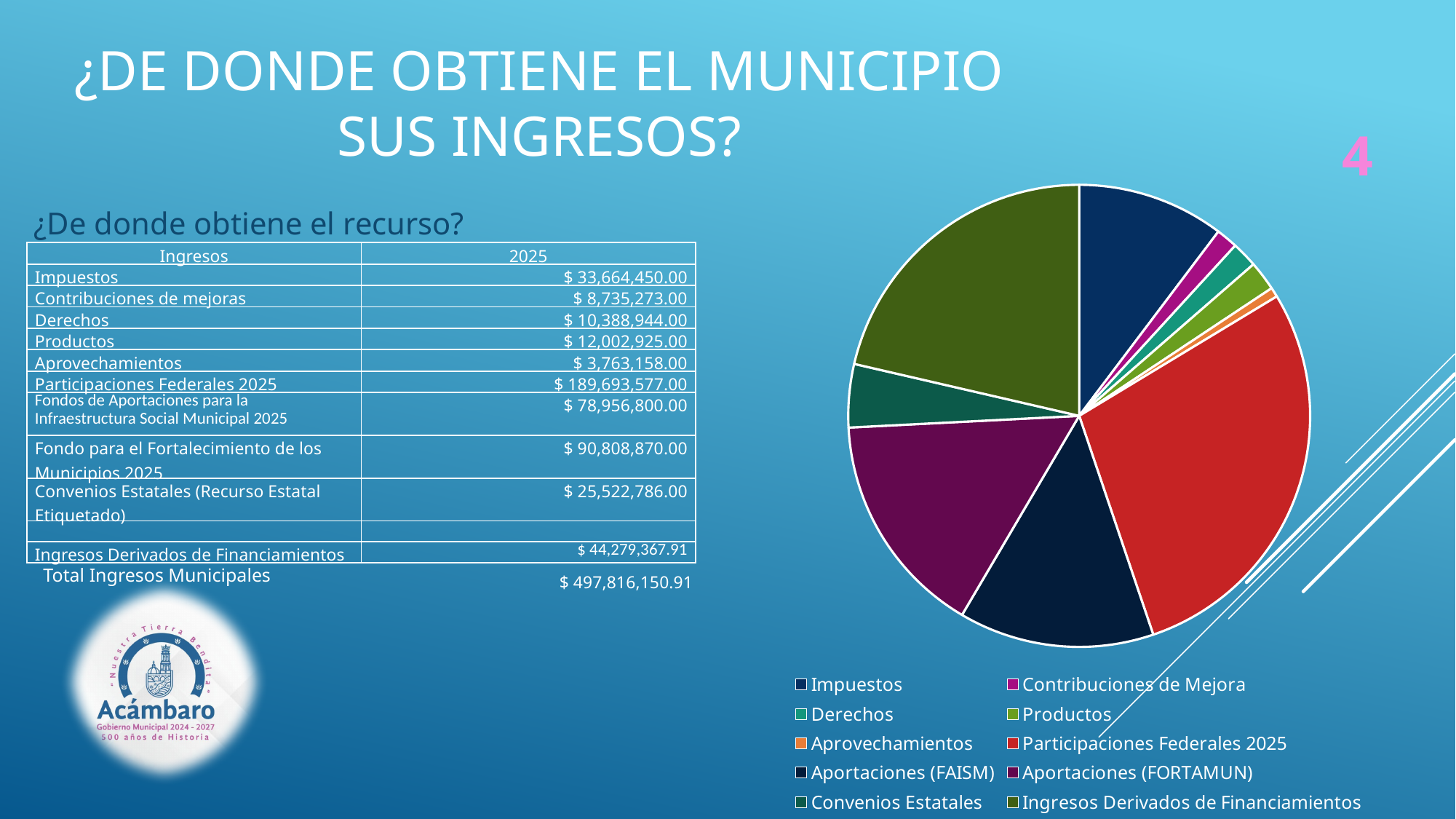
How many entries does the pie chart's legend list? 10 What is the 2025 value for Aprovechamientos? $ 3,763,158.00 What is the 2025 value for Participaciones Federales 2025? $ 189,693,577.00 What kind of chart is shown on the slide? pie chart What is the Total Ingresos Municipales shown on the slide? $ 497,816,150.91 How many slices does the pie chart have? 10 Which category has the smallest slice in the pie chart? Aprovechamientos What is the 2025 value for Ingresos Derivados de Financiamientos? $ 44,279,367.91 What is the difference between the values for Impuestos and Derechos? $ 23,275,506.00 What is the 2025 value for Impuestos? $ 33,664,450.00 Which category has the largest slice in the pie chart? Participaciones Federales 2025 Which slice is larger, Impuestos or Ingresos Derivados de Financiamientos? Ingresos Derivados de Financiamientos